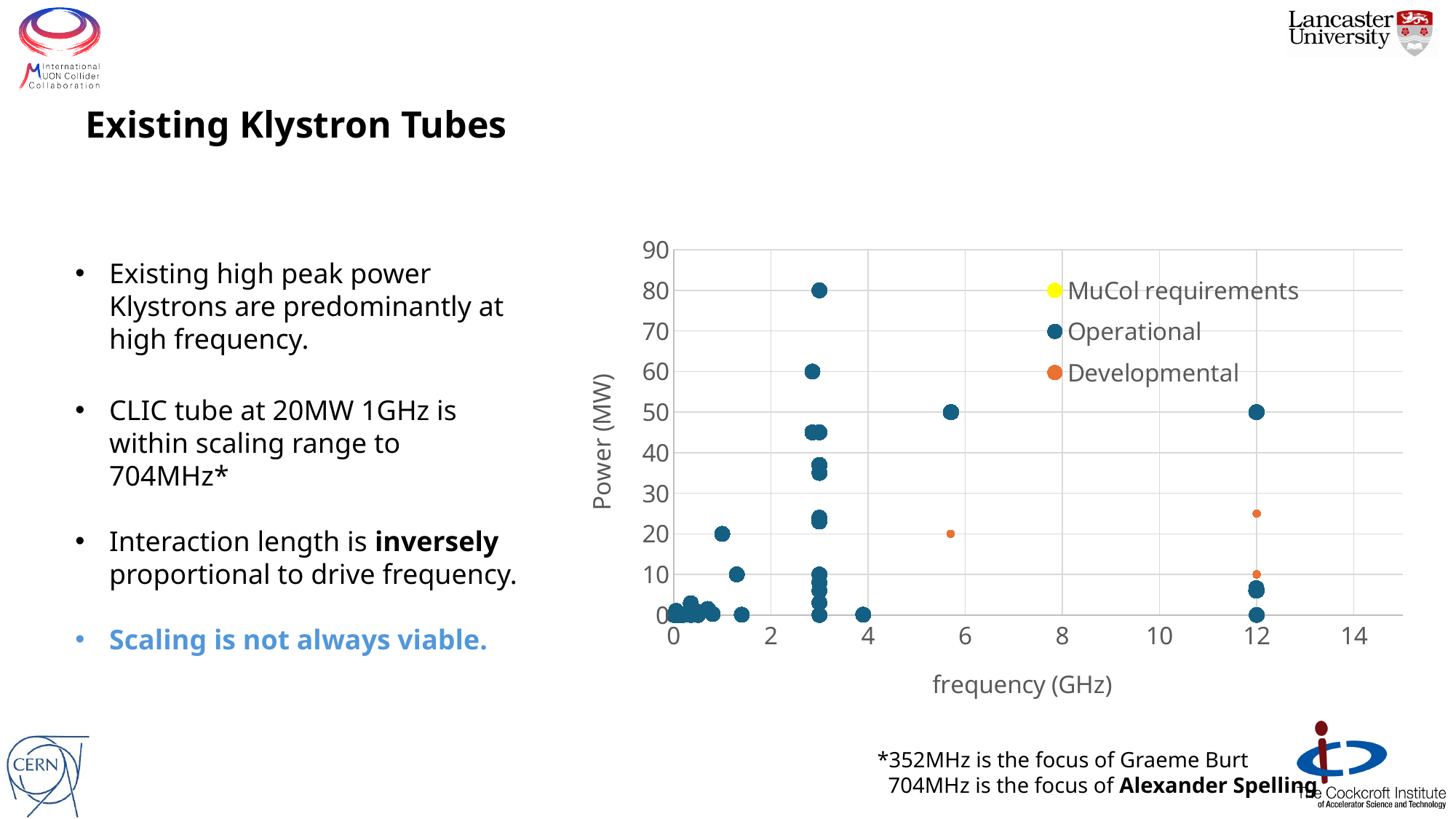
What are the three series named in the chart legend? MuCol requirements, Operational, Developmental What is the highest value shown on the frequency (GHz) axis? 14 Is the highest Operational point on the chart greater or less than 70 MW? greater Is the highest Operational point near 12 GHz greater or less than 40 MW? greater What kind of chart is shown on the slide? scatter chart Which series has the highest-power point on the chart, Operational or Developmental? Operational Is the highest Developmental point near 12 GHz greater or less than 20 MW? greater What is the label of the chart's vertical axis? Power (MW) How many series does the chart legend list? 3